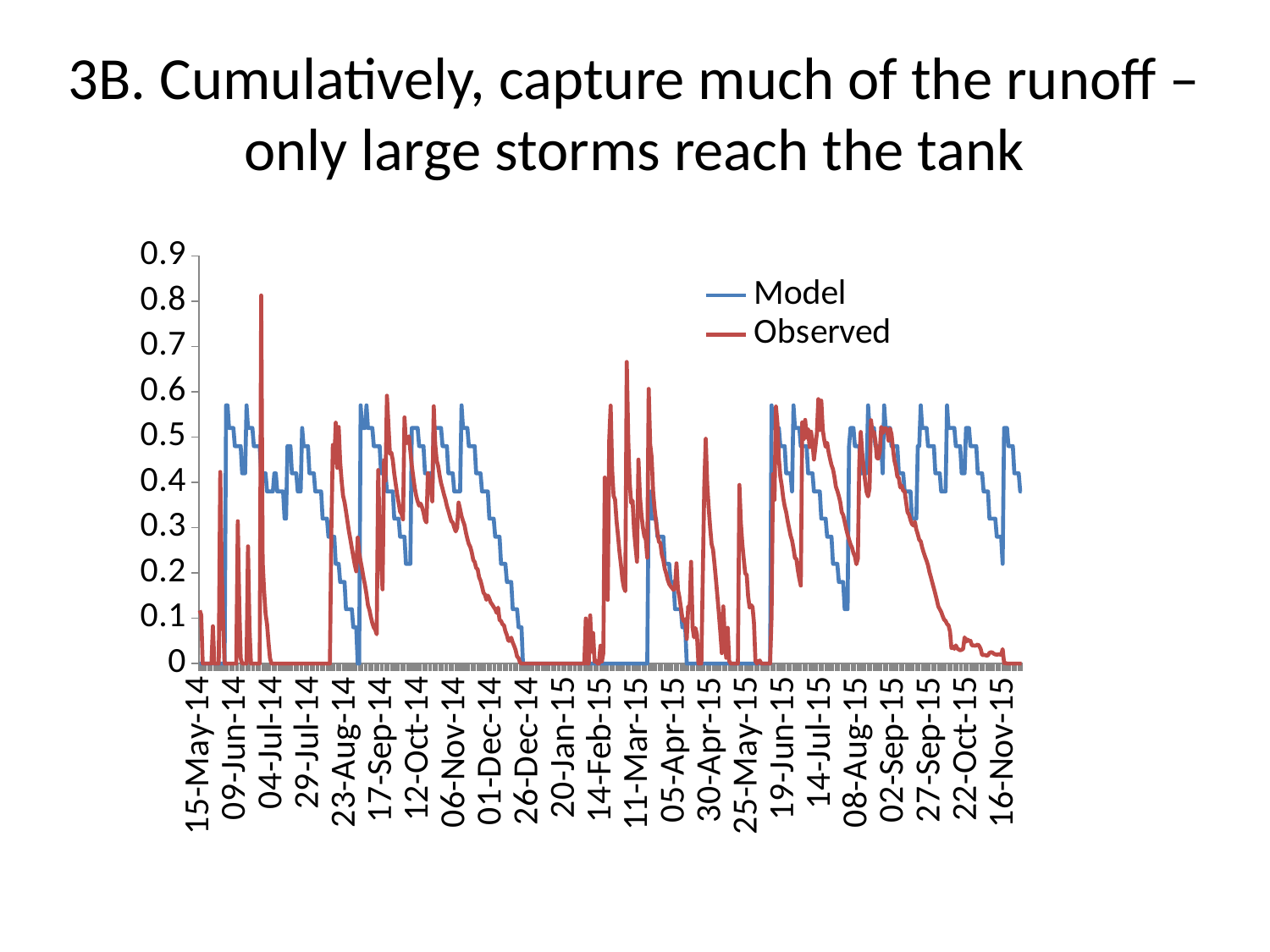
Which colour is used for the Observed series? red Is the highest value of the Observed series greater or less than 0.7? greater Is the highest value of the Model series greater or less than 0.6? less Is the Observed value around 16-Nov-15 greater or less than 0.1? less How many series does the legend list? 2 Which series reaches the higher peak value over the whole period, Model or Observed? Observed What are the two series named in the legend? Model and Observed What is the first date label on the x axis? 15-May-14 What is the highest value shown on the y axis? 0.9 What kind of chart is shown on the slide? line chart